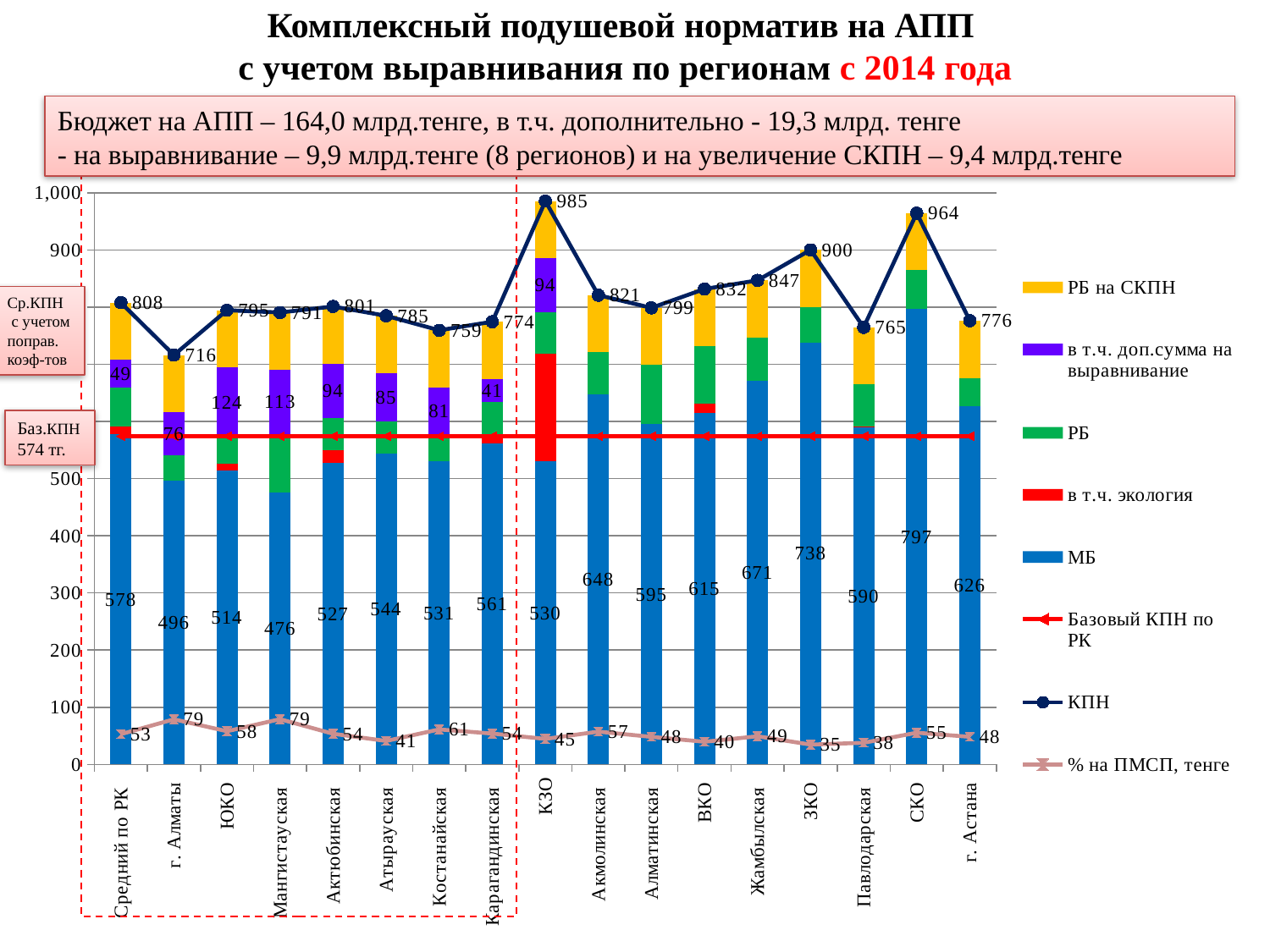
What is the difference between the КПН values for КЗО and СКО? 21 Which has the larger КПН value, ЗКО or Жамбылская? ЗКО How many series does the legend list? 8 Which region has the lowest КПН value? г. Алматы What is the МБ value for СКО? 797 What is the КПН value for КЗО? 985 What is the % на ПМСП value for г. Алматы? 79 What is the доп.сумма на выравнивание value for ЮКО? 124 Which region has the highest КПН value? КЗО Which region has the lowest МБ value? Мангистауская What kind of chart is shown on the slide? Stacked bar chart with line series Is the МБ value for ЗКО greater or less than 700? greater